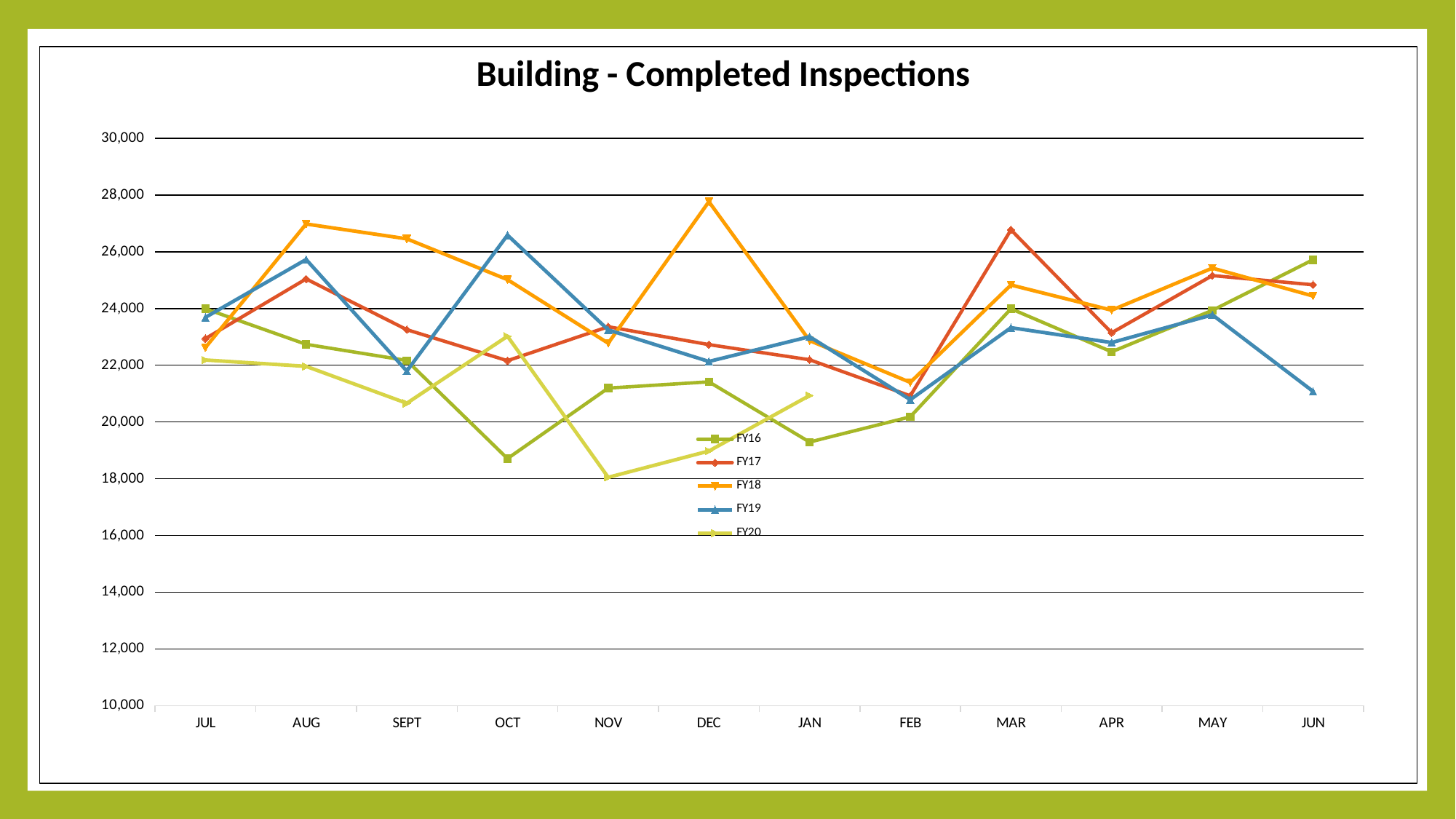
In which month does the FY17 series reach its highest value? MAR How many series does the legend list? 5 Is the FY19 value for JUN greater or less than 22,000? less What type of chart is shown on the slide? line chart In which month does the FY16 series reach its lowest value? OCT In which month does the FY18 series reach its highest value? DEC Which series has the larger value in DEC, FY18 or FY16? FY18 In which month does the FY20 series reach its lowest value? NOV What is the title of the chart? Building - Completed Inspections Does the FY20 series rise or fall from JUL to NOV? fall Is the FY18 value for DEC greater or less than 26,000? greater How many months are shown on the x axis? 12